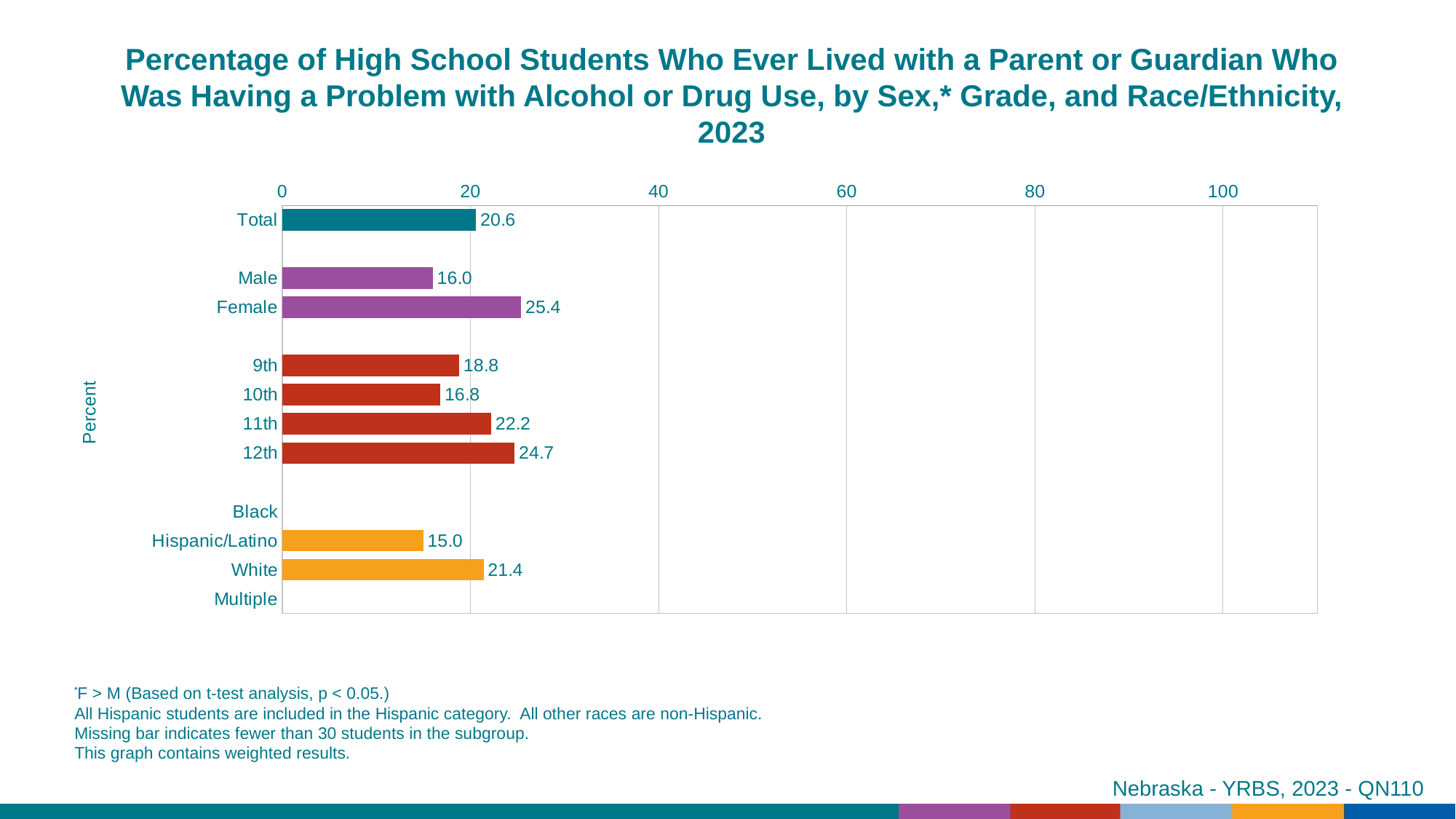
What is the difference between the Female and Male values? 9.4 What is the value for Total? 20.6 What kind of chart is shown? bar chart Is the value for White greater or less than 20? greater Which category has the highest value? Female What is the value for Female? 25.4 Which is larger, the value for 11th grade or the value for 12th grade? 12th Among the categories with bars, which has the lowest value? Hispanic/Latino Do the values rise or fall from 10th grade to 12th grade? rise Which race/ethnicity categories have no bar shown? Black and Multiple What is the value for 10th grade? 16.8 What is the value for Hispanic/Latino? 15.0